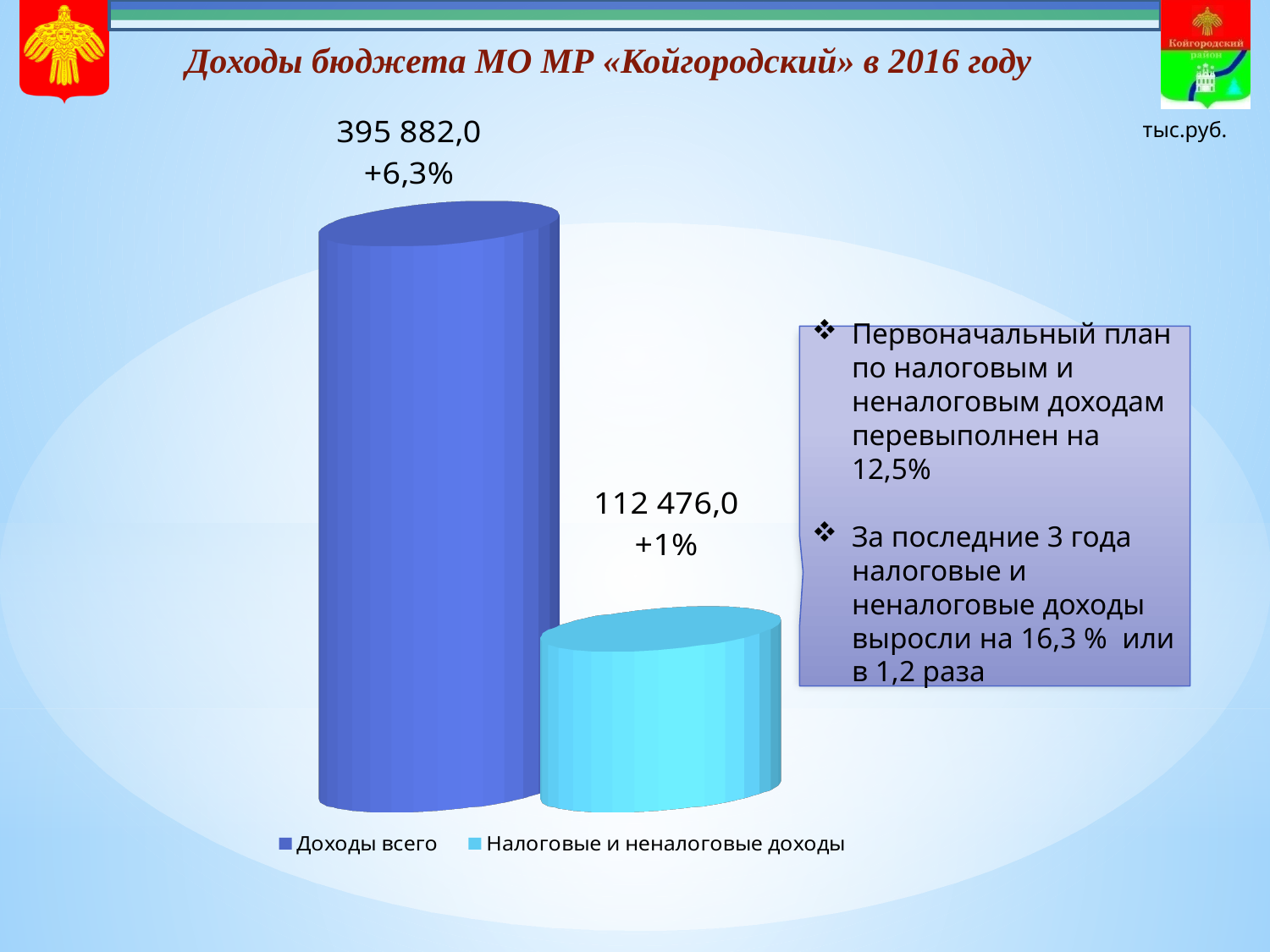
Which series has the lowest value on the chart? Налоговые и неналоговые доходы How many bars are plotted on the chart? 2 What is the value shown for «Налоговые и неналоговые доходы»? 112 476,0 How many series does the legend list? 2 In what units are the chart values given, according to the slide? тыс.руб. Which series has the highest value on the chart? Доходы всего Which is larger: «Доходы всего» or «Налоговые и неналоговые доходы»? Доходы всего What kind of chart is shown on the slide? Bar chart What percentage change is shown next to the «Доходы всего» bar? +6,3% What percentage change is shown next to the «Налоговые и неналоговые доходы» bar? +1% What is the value shown for «Доходы всего»? 395 882,0 What is the difference between «Доходы всего» and «Налоговые и неналоговые доходы»? 283 406,0